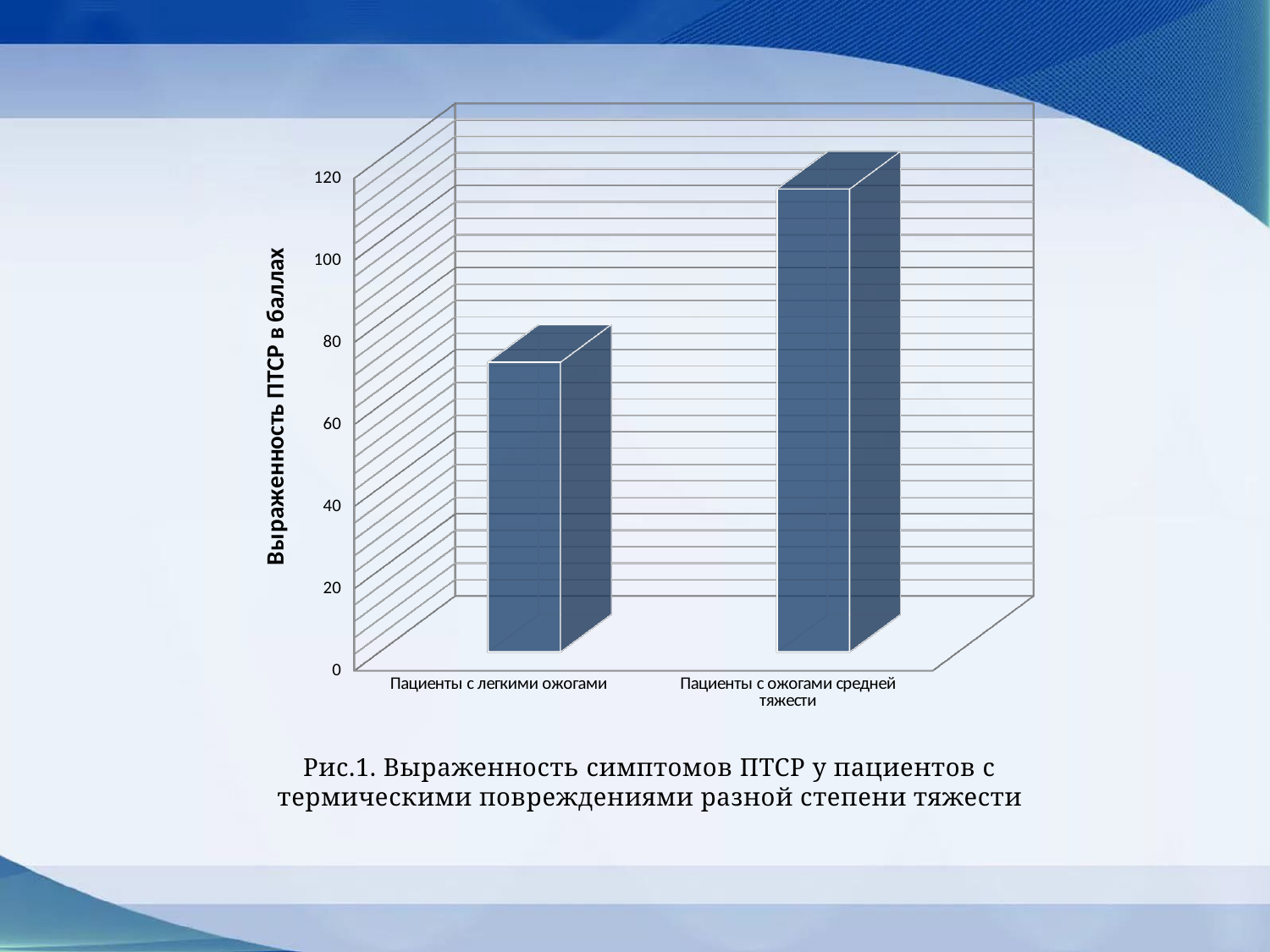
Is the value for Пациенты с ожогами средней тяжести greater or less than 80? greater Is the value for Пациенты с ожогами средней тяжести greater or less than 100? greater What is the label of the vertical axis of the chart? Выраженность ПТСР в баллах Is the value for Пациенты с легкими ожогами greater or less than 80? less Which category has the highest value on the chart? Пациенты с ожогами средней тяжести How many categories are plotted on the chart? 2 Which is larger: the value for Пациенты с легкими ожогами or the value for Пациенты с ожогами средней тяжести? Пациенты с ожогами средней тяжести What is the highest tick value shown on the vertical axis? 120 Which category has the lowest value on the chart? Пациенты с легкими ожогами What kind of chart is shown on the slide? bar chart